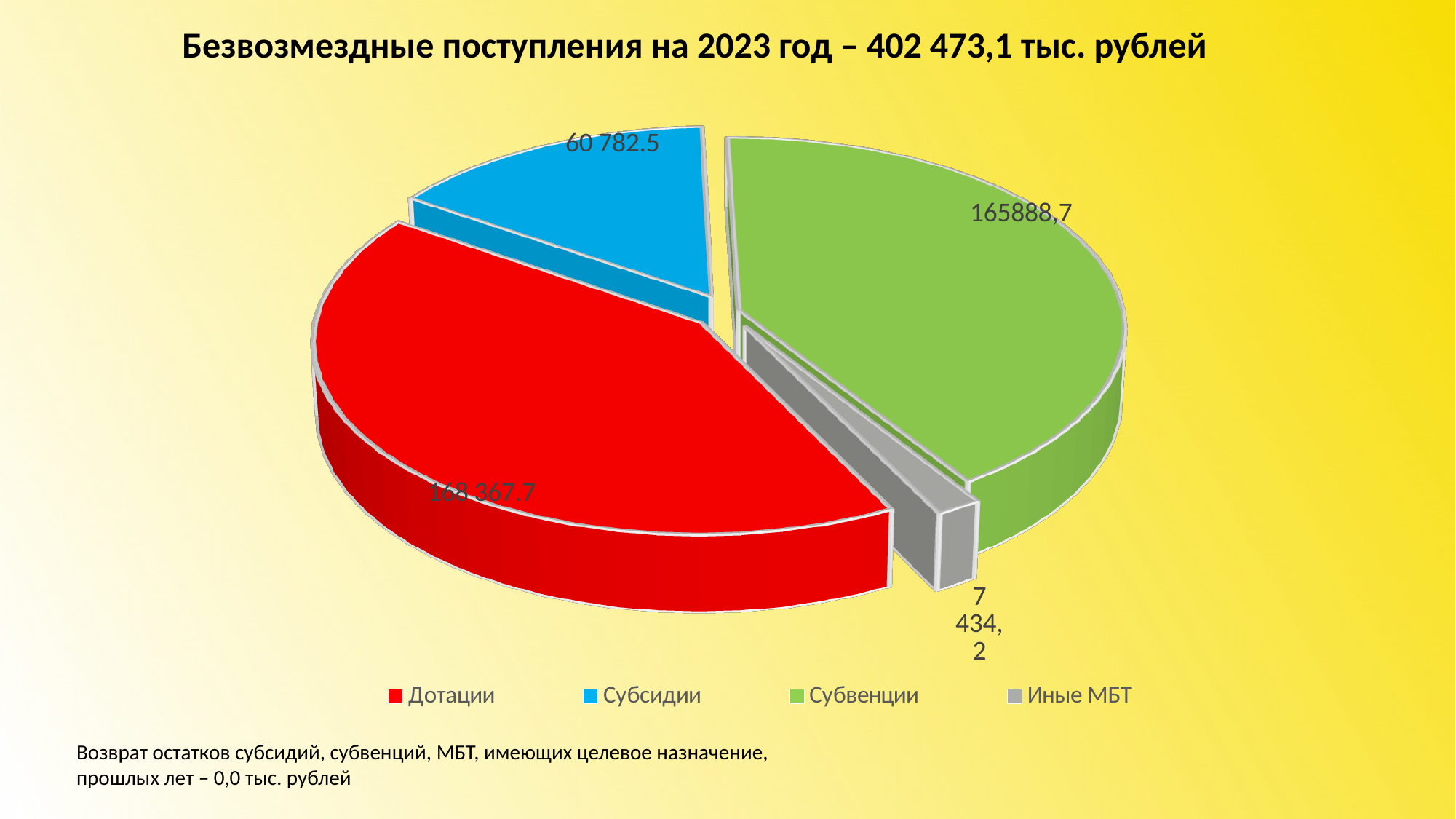
How many entries does the legend list? 4 Which category has the smallest slice of the pie? Иные МБТ Which category has the largest value? Дотации What total amount is stated in the chart title for 2023? 402 473,1 тыс. рублей What kind of chart is shown on the slide? Pie chart How many categories does the pie chart have? 4 What is the value for Дотации? 168 367.7 What is the value for Иные МБТ? 7 434,2 Which is larger, Субсидии or Иные МБТ? Субсидии What is the value for Субсидии? 60 782.5 What is the value for Субвенции? 165888,7 What is the difference between the values for Дотации and Субсидии? 107 585.2